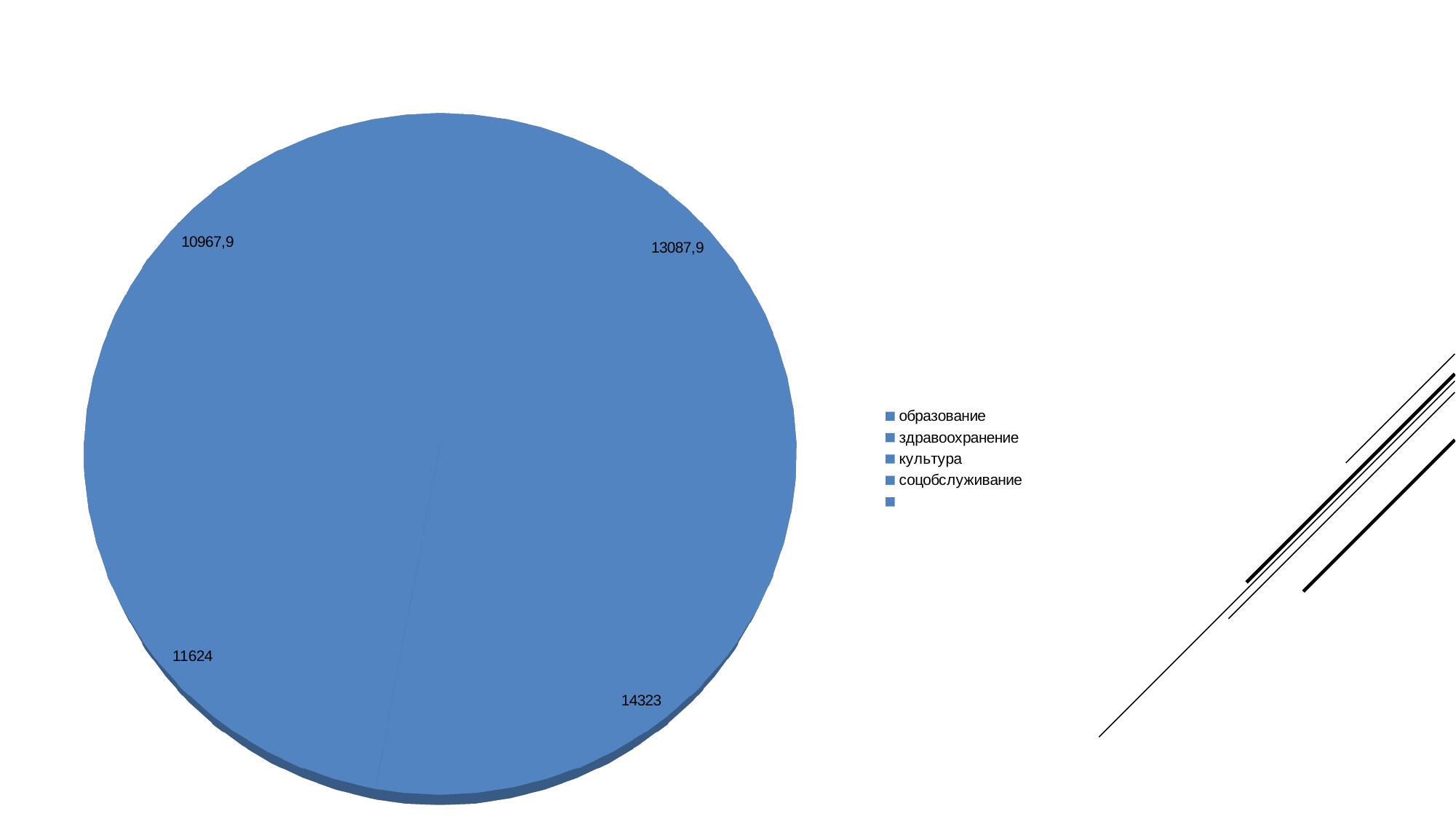
Which is larger, the value 13087,9 or the value 11624? 13087,9 What kind of chart is shown on the slide? pie chart What is the difference between the values 14323 and 11624 on the pie chart? 2699 What is the difference between the largest printed value (14323) and the value 13087,9? 1235,1 How many data labels are printed on the pie chart? 4 What is the largest value printed on the pie chart? 14323 What is the first entry listed in the chart legend? образование What is the last named entry in the chart legend? соцобслуживание What is the total of the four values printed on the pie chart? 50002,8 What is the difference between the values 13087,9 and 10967,9 on the pie chart? 2120 What is the smallest value printed on the pie chart? 10967,9